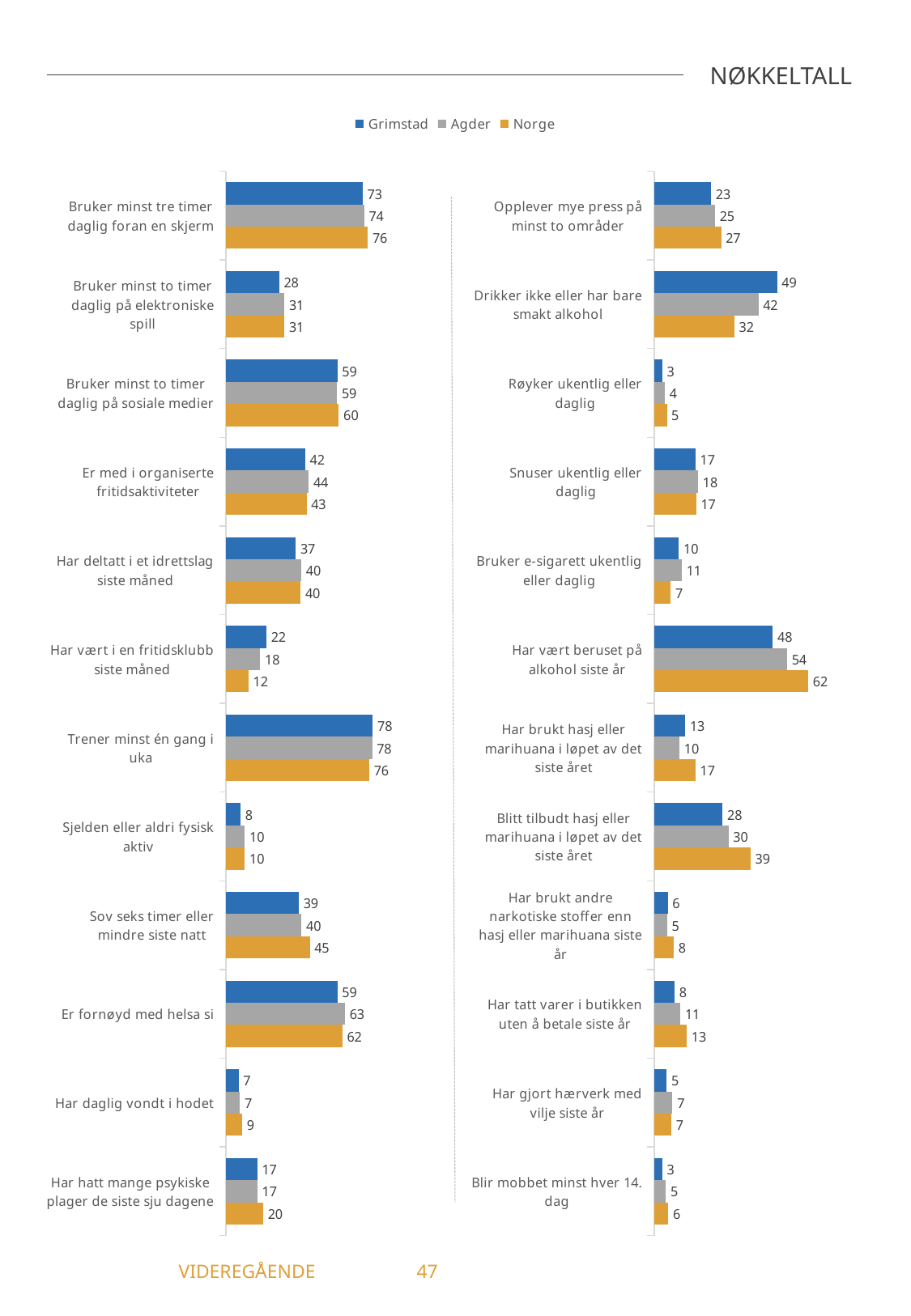
How many categories are shown in the left chart? 12 In the left chart, what is the Grimstad value for "Bruker minst tre timer daglig foran en skjerm"? 73 In the left chart, for "Har vært i en fritidsklubb siste måned", which is larger: the Grimstad value or the Norge value? Grimstad In the right chart, what is the Norge value for "Har vært beruset på alkohol siste år"? 62 In the right chart, what is the difference between the Norge and Grimstad values for "Blitt tilbudt hasj eller marihuana i løpet av det siste året"? 11 Which colour represents Norge in the legend? Orange In the right chart, for "Har brukt hasj eller marihuana i løpet av det siste året", which is larger: the Agder value or the Norge value? Norge In the right chart, which category has the highest Grimstad value? Drikker ikke eller har bare smakt alkohol What kind of chart is the right chart? Bar chart In the left chart, what is the Agder value for "Er fornøyd med helsa si"? 63 How many series does the legend list? 3 In the left chart, which category has the lowest Norge value? Har daglig vondt i hodet